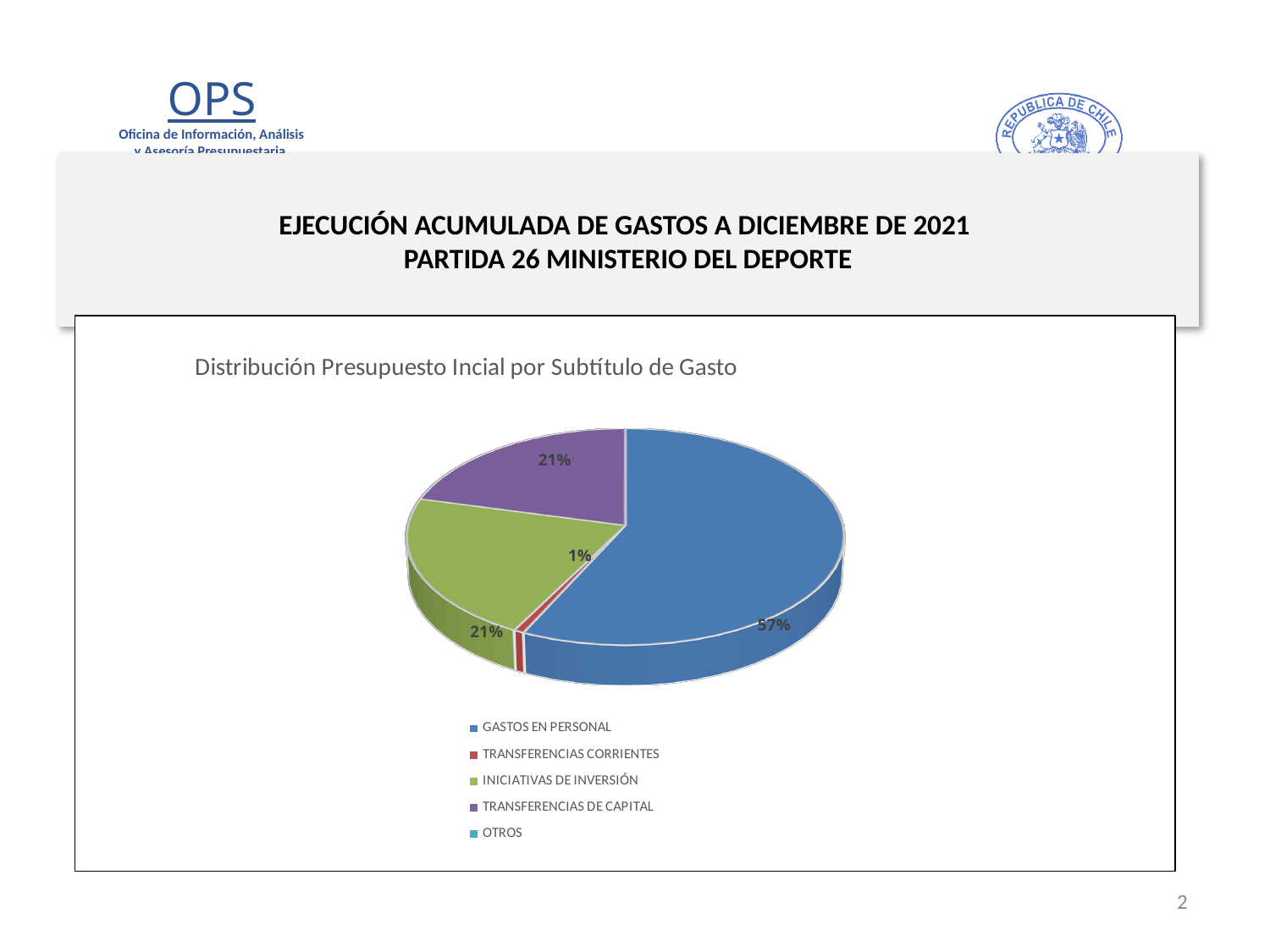
What share of the pie does TRANSFERENCIAS CORRIENTES represent? 1% Which is larger, the share for GASTOS EN PERSONAL or the share for INICIATIVAS DE INVERSIÓN? GASTOS EN PERSONAL What type of chart is shown on the slide? Pie chart What share of the pie does INICIATIVAS DE INVERSIÓN represent? 21% Which of the labelled slices is the smallest? TRANSFERENCIAS CORRIENTES Which category has the largest slice of the pie? GASTOS EN PERSONAL By how many percentage points does the GASTOS EN PERSONAL share exceed the TRANSFERENCIAS DE CAPITAL share? 36 percentage points How many categories does the legend list? 5 What is the title of the chart? Distribución Presupuesto Incial por Subtítulo de Gasto What share of the pie does TRANSFERENCIAS DE CAPITAL represent? 21% What colour is the GASTOS EN PERSONAL slice? Blue